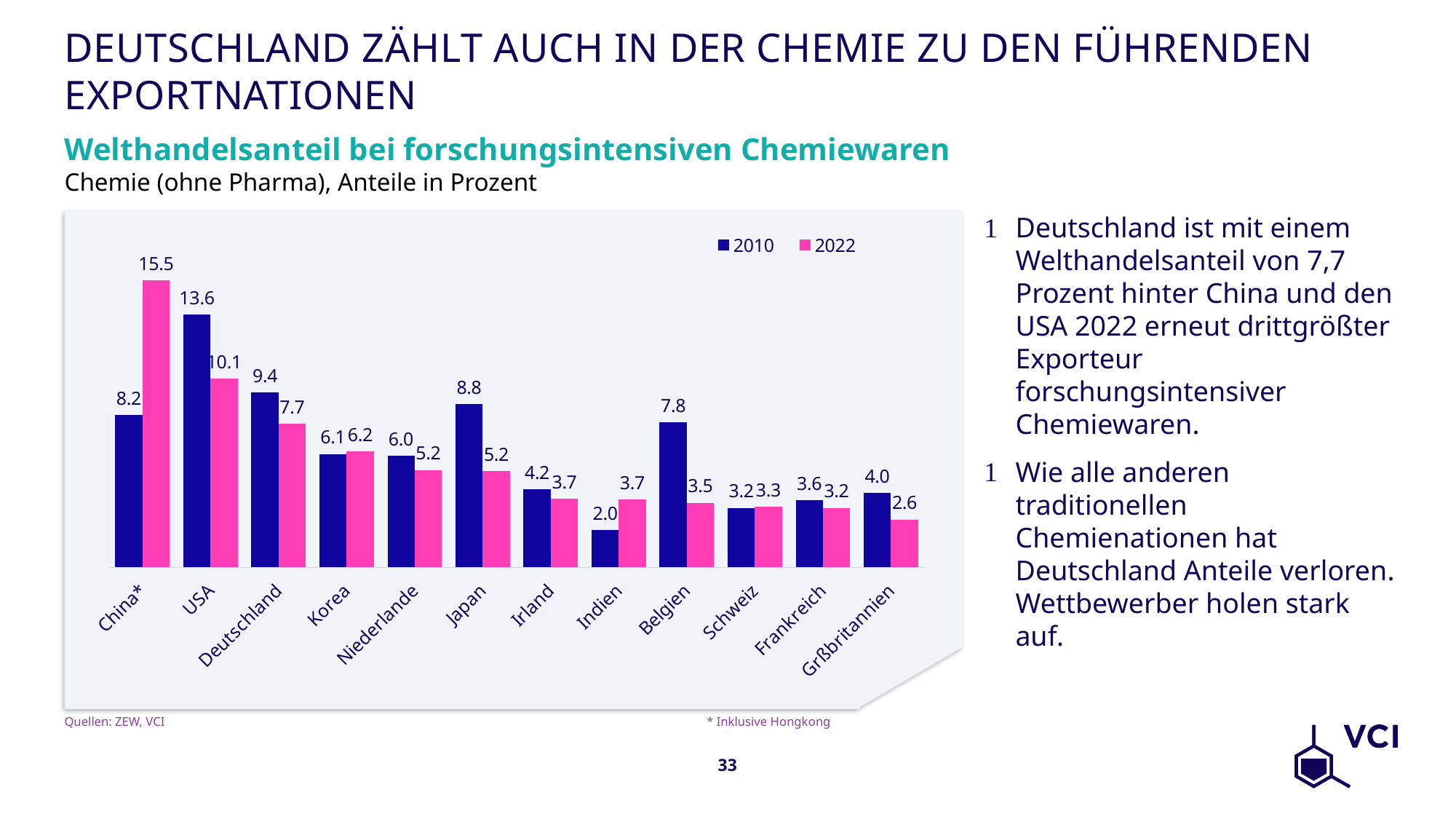
Which country has the highest 2022 value? China* What is the 2022 value for Indien? 3.7 How many countries are shown on the x axis? 12 What is the difference between the 2010 and 2022 values for Belgien? 4.3 What is the difference between the 2010 and 2022 values for China*? 7.3 How many series does the legend list? 2 What is the 2010 value for Japan? 8.8 What kind of chart is shown on the slide? Bar chart Which country has the highest 2010 value? USA What is the 2022 value for Deutschland? 7.7 Which is larger for USA, the 2010 value or the 2022 value? 2010 Which country has the lowest 2010 value? Indien